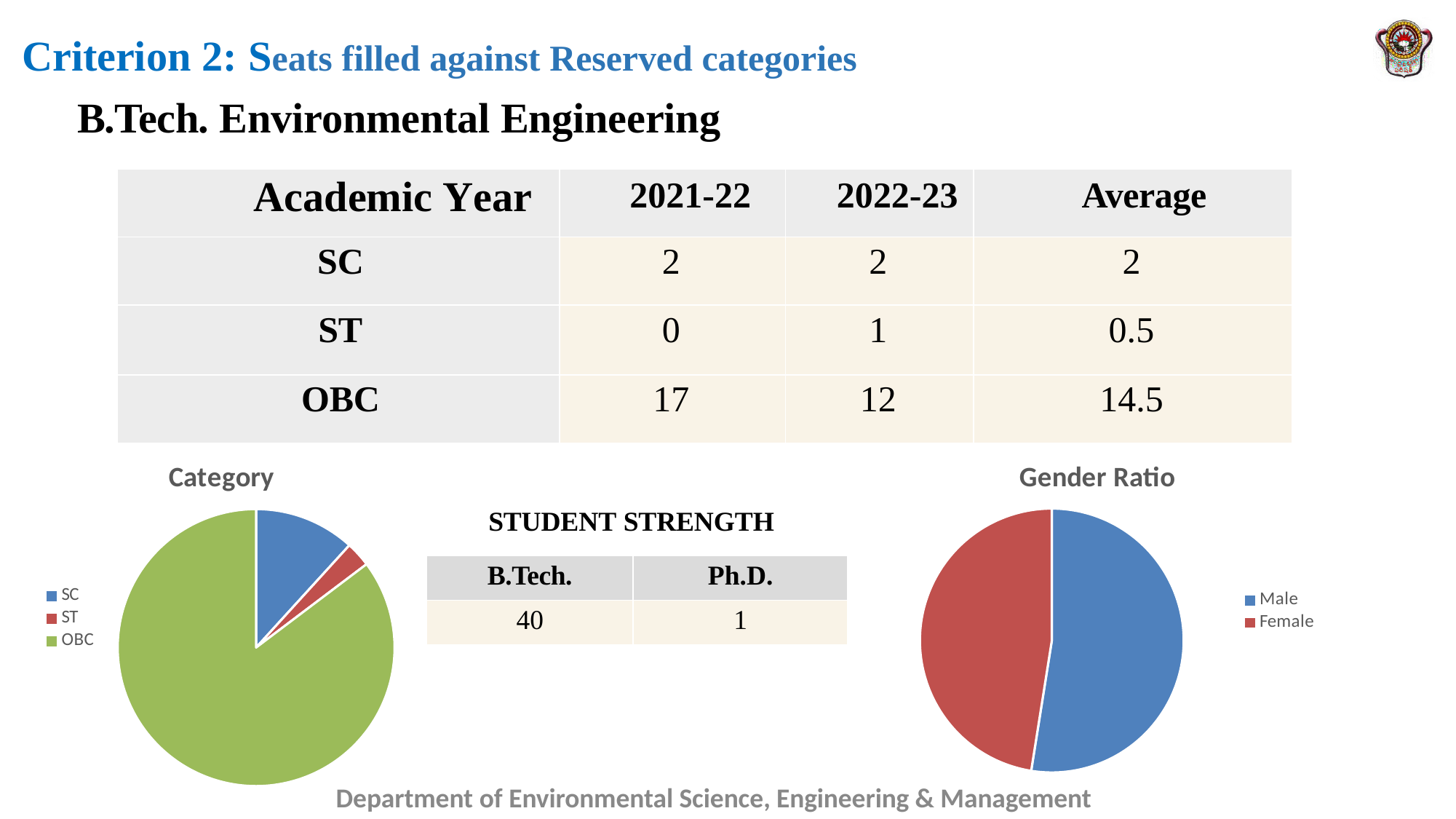
How many slices does the "Gender Ratio" pie chart have? 2 How many slices does the "Category" pie chart have? 3 In the "Category" pie chart, which category has the smallest slice? ST What is the title of the pie chart on the right side of the slide? Gender Ratio How many entries does the legend of the "Gender Ratio" pie chart list? 2 What kind of chart is the "Gender Ratio" chart on the slide? pie chart In the "Category" pie chart, which category has the largest slice? OBC How many entries does the legend of the "Category" pie chart list? 3 What kind of chart is the "Category" chart on the slide? pie chart In the "Gender Ratio" pie chart, what colour is the Female slice? red In the "Category" pie chart, which slice is larger, SC or ST? SC In the "Category" pie chart, which slice is larger, OBC or SC? OBC